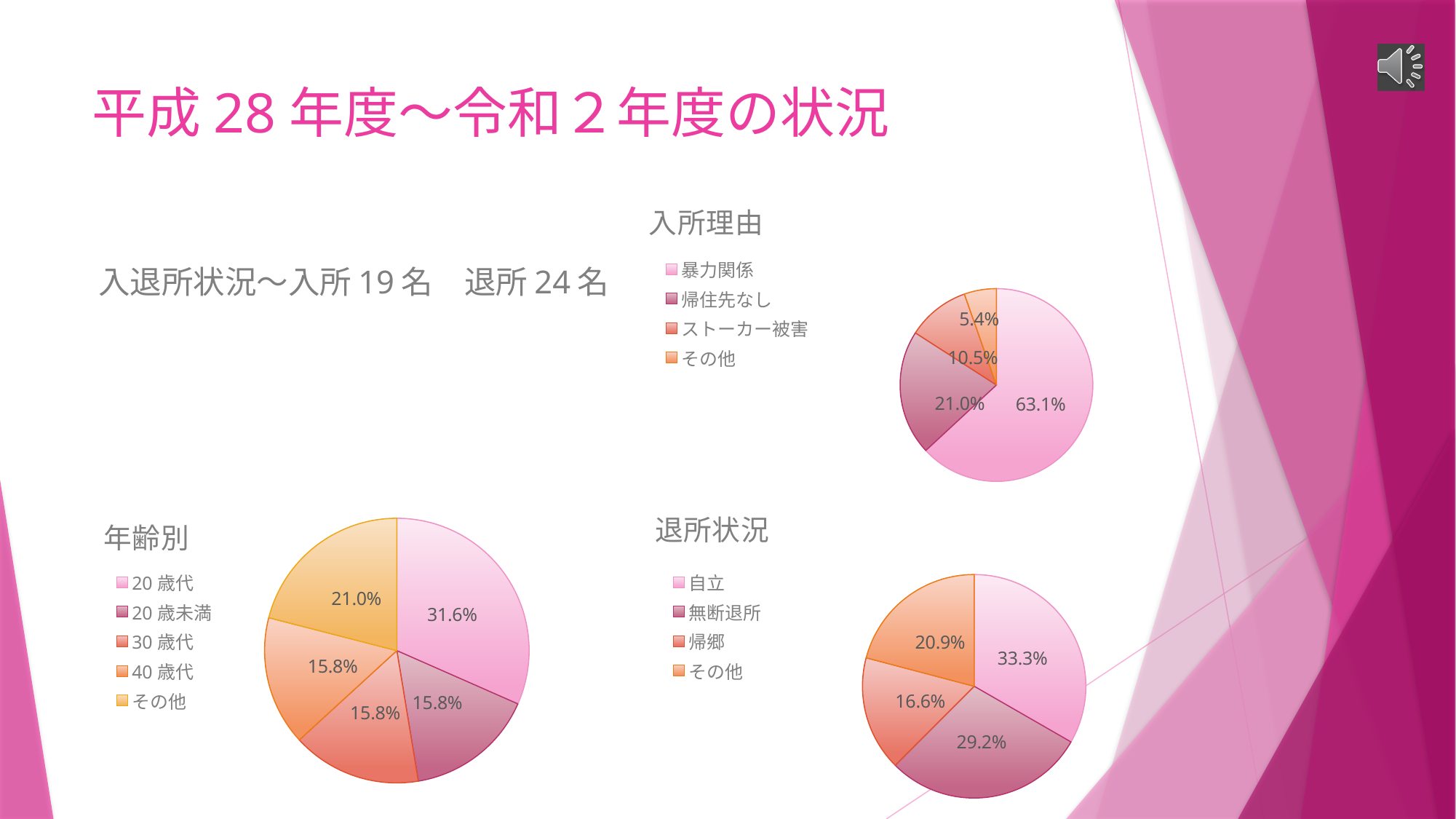
In the 年齢別 pie chart, what is the value for 20 歳代? 31.6% How many categories does the 年齢別 pie chart show? 5 In the 退所状況 pie chart, what is the difference between 自立 and 帰郷? 16.7% In the 退所状況 pie chart, what is the value for 無断退所? 29.2% In the 年齢別 pie chart, what is the value for その他? 21.0% In the 退所状況 pie chart, which is larger, 帰郷 or その他? その他 In the 入所理由 pie chart, what is the value for ストーカー被害? 10.5% In the 入所理由 pie chart, which category has the smallest slice? その他 In the 入所理由 pie chart, what share does 暴力関係 have? 63.1% In the 入所理由 pie chart, what is the difference between 暴力関係 and 帰住先なし? 42.1% What type of chart is the 退所状況 chart? Pie chart In the 年齢別 pie chart, which category has the largest slice? 20 歳代